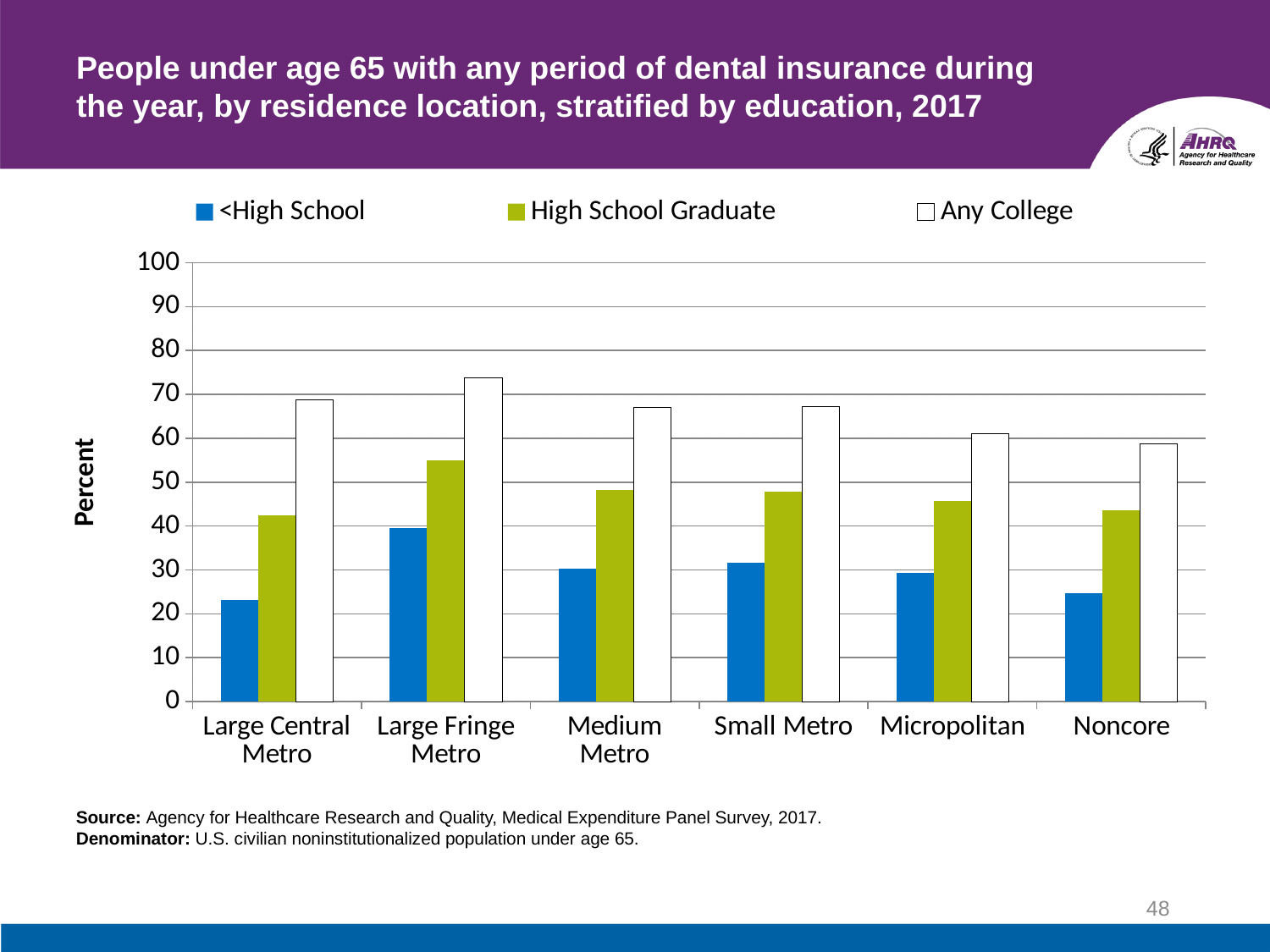
Is the value for Any College in Large Central Metro greater or less than 60? greater Is the value for <High School in Large Central Metro greater or less than 30? less Is the value for High School Graduate in Large Fringe Metro greater or less than 50? greater What is the label on the y axis? Percent What kind of chart is shown on the slide? Bar chart Which residence location has the lowest value for Any College? Noncore How many residence location categories are shown on the x axis? 6 Which is larger: the <High School value for Large Fringe Metro or for Noncore? Large Fringe Metro Which residence location has the highest value for Any College? Large Fringe Metro How many series does the legend list? 3 Which residence location has the highest value for <High School? Large Fringe Metro Which series is shown with white (unfilled) bars? Any College